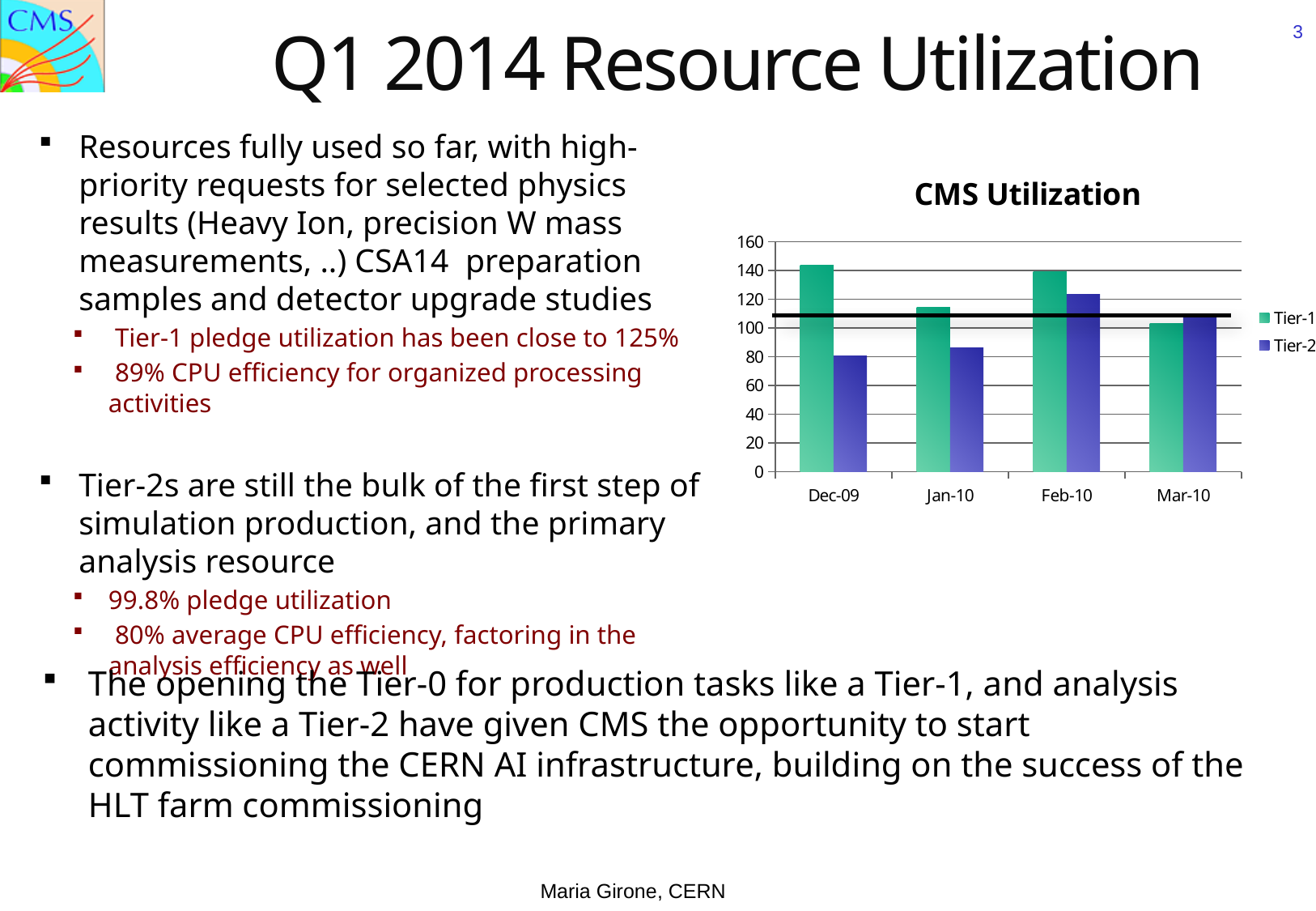
What kind of chart is the CMS Utilization chart? bar chart In the CMS Utilization chart, is the Tier-1 or the Tier-2 value larger for Dec-09? Tier-1 In the CMS Utilization chart, do the Tier-2 values rise or fall from Dec-09 to Feb-10? rise In the CMS Utilization chart, which month has the lowest Tier-1 value? Mar-10 What colour are the Tier-1 bars in the CMS Utilization chart? green How many series does the legend of the CMS Utilization chart list? 2 How many months are shown on the x axis of the CMS Utilization chart? 4 In the CMS Utilization chart, is the Tier-2 value for Dec-09 greater or less than 100? less In the CMS Utilization chart, is the Tier-2 value for Feb-10 greater or less than 100? greater In the CMS Utilization chart, which month has the highest Tier-2 value? Feb-10 In the CMS Utilization chart, is the Tier-1 or the Tier-2 value larger for Feb-10? Tier-1 In the CMS Utilization chart, is the Tier-1 value for Dec-09 greater or less than 120? greater